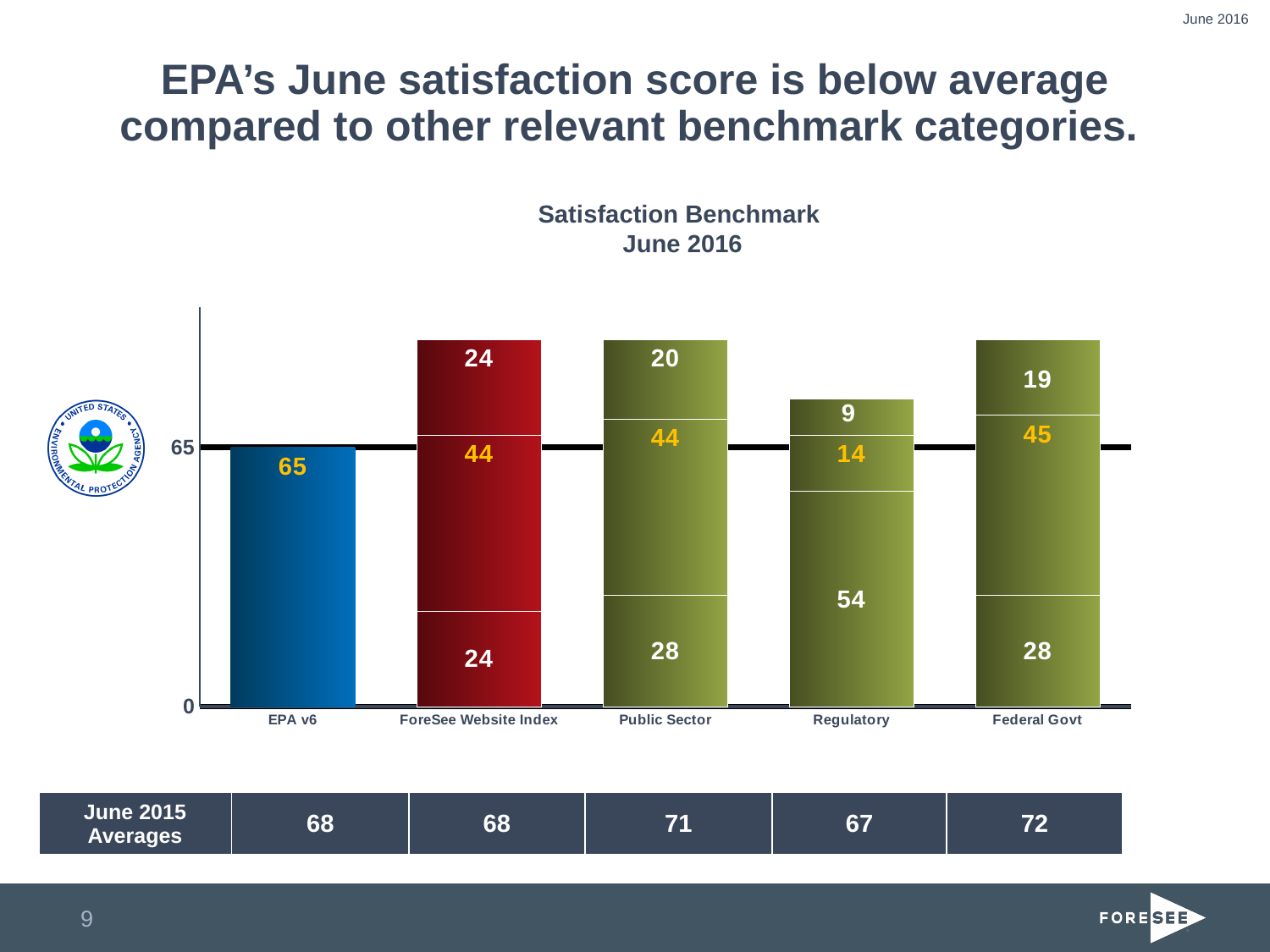
What type of chart is shown on the slide? Stacked bar chart What is the total of the stacked Regulatory bar? 77 Which is larger, the top segment of ForeSee Website Index or the top segment of Public Sector? ForeSee Website Index What is the difference between the bottom segment of Regulatory and the bottom segment of Public Sector? 26 Which category has the largest bottom segment? Regulatory What is the value shown for EPA v6? 65 How many categories are shown along the x axis of the chart? 5 What is the value of the bottom segment of the Regulatory bar? 54 What is the title of the chart? Satisfaction Benchmark June 2016 What is the value of the top segment of the Federal Govt bar? 19 What is the total of the stacked Public Sector bar? 92 What is the value of the middle segment of the ForeSee Website Index bar? 44